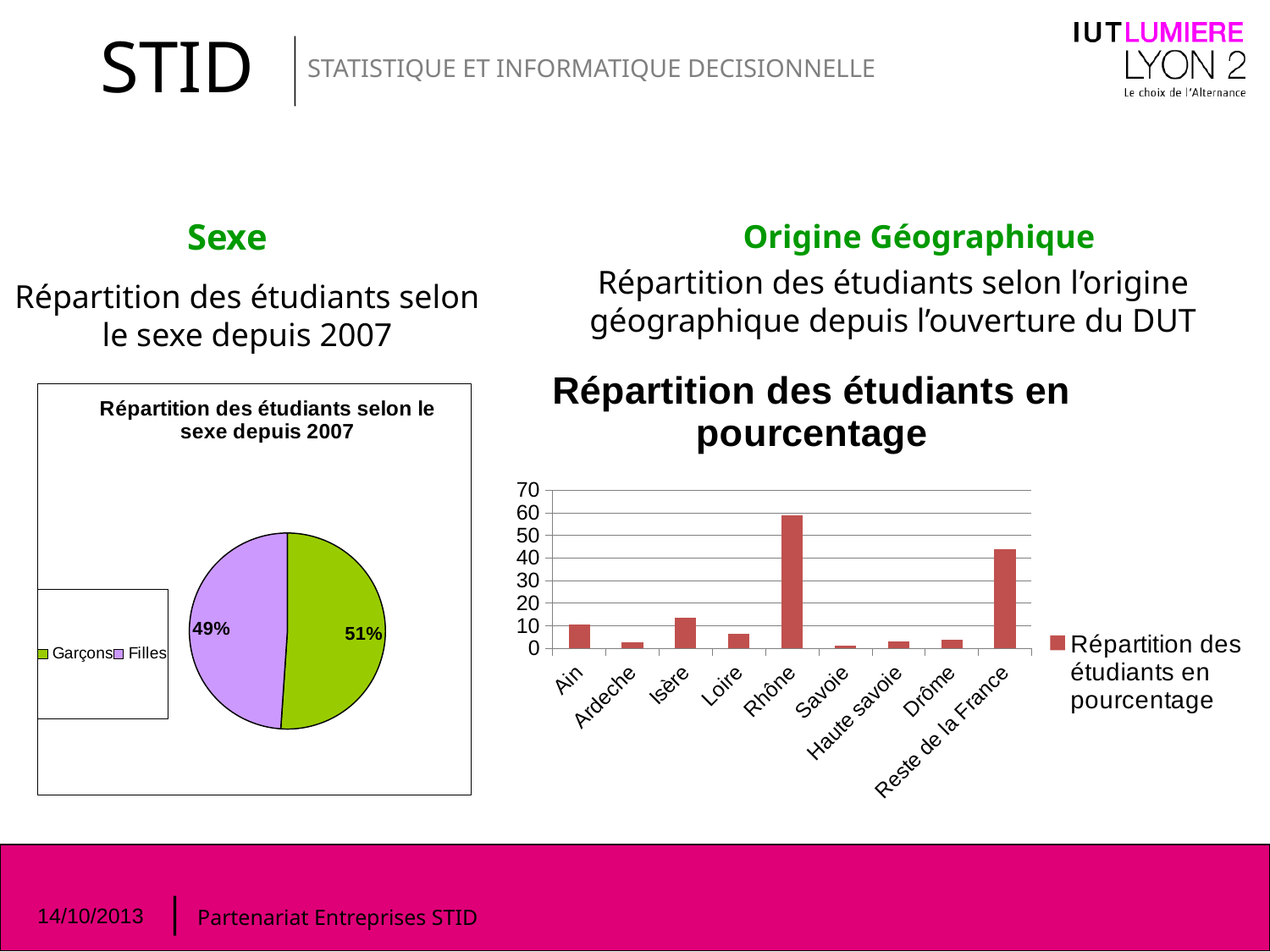
How many categories are shown on the x axis of the chart 'Répartition des étudiants en pourcentage'? 9 In the pie chart on the left, what percentage of students are Garçons? 51% In the chart 'Répartition des étudiants en pourcentage', which category has the highest value? Rhône In the chart 'Répartition des étudiants en pourcentage', is the value for Reste de la France greater or less than 40? greater In the chart 'Répartition des étudiants en pourcentage', is the value for Rhône greater or less than 50? greater In the pie chart on the left, which slice is larger, Garçons or Filles? Garçons What kind of chart is the chart on the left titled 'Répartition des étudiants selon le sexe depuis 2007'? Pie chart In the pie chart on the left, what percentage of students are Filles? 49% In the chart 'Répartition des étudiants en pourcentage', which is larger, the value for Isère or the value for Loire? Isère In the chart 'Répartition des étudiants en pourcentage', is the value for Loire greater or less than 10? less What kind of chart is the chart titled 'Répartition des étudiants en pourcentage'? Bar chart In the pie chart on the left, what is the difference in percentage points between Garçons and Filles? 2 percentage points